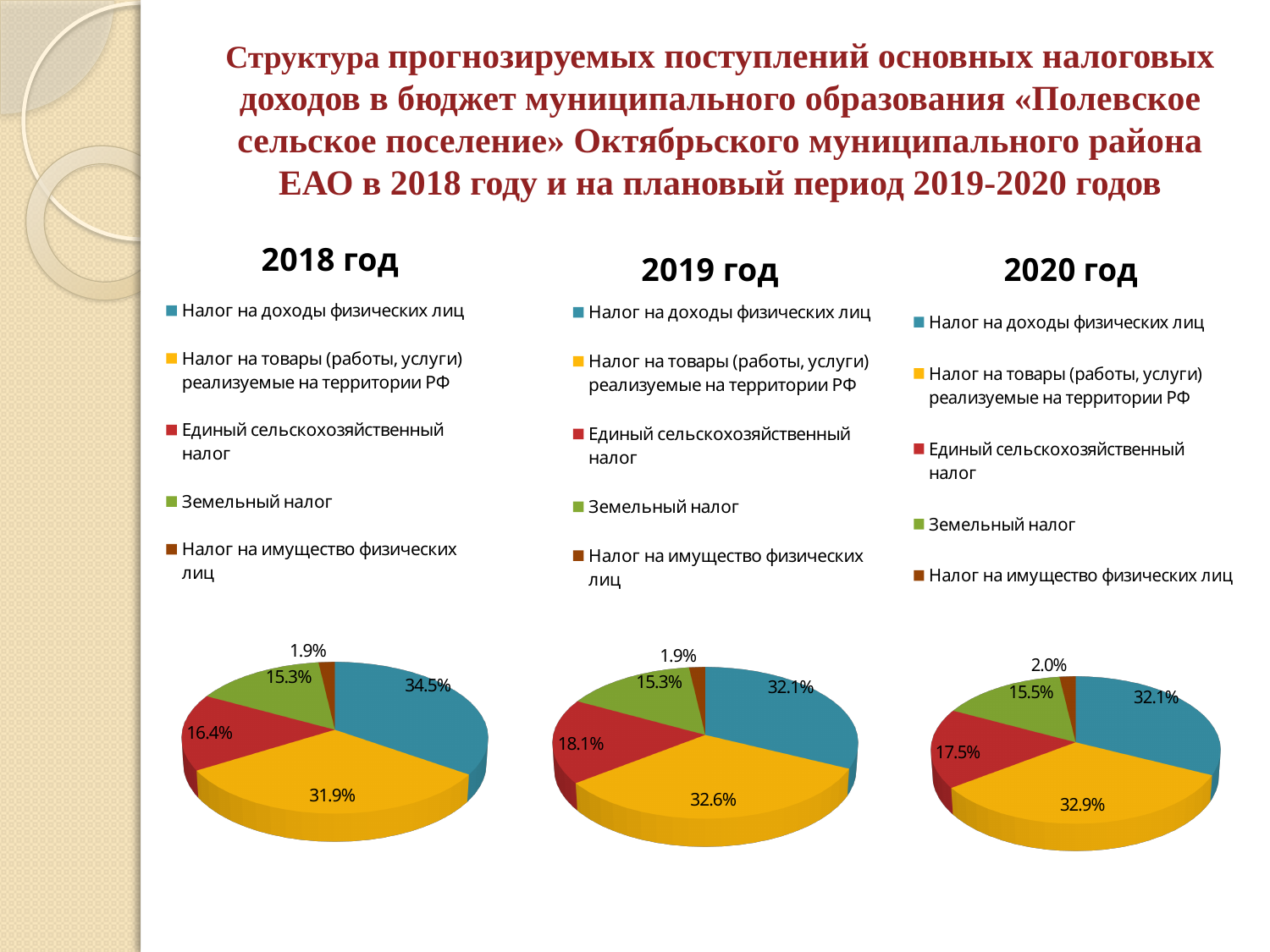
What type of chart is used for "2018 год"? Pie chart In the "2019 год" chart, which category has the smallest share? Налог на имущество физических лиц In the "2018 год" chart, which category has the largest share? Налог на доходы физических лиц In the "2020 год" chart, which is larger: the share of Единый сельскохозяйственный налог or the share of Земельный налог? Единый сельскохозяйственный налог In the "2018 год" chart, what is the difference between the shares of Налог на доходы физических лиц and Налог на товары (работы, услуги) реализуемые на территории РФ? 2.6% In the "2020 год" chart, what share is shown for Налог на товары (работы, услуги) реализуемые на территории РФ? 32.9% In the "2019 год" chart, what colour is the slice for Земельный налог? Green How many slices does the "2019 год" pie chart have? 5 In the "2019 год" chart, what share is shown for Единый сельскохозяйственный налог? 18.1% How many charts are shown on the slide? 3 In the "2020 год" chart, what share is shown for Налог на имущество физических лиц? 2.0% In the "2018 год" chart, what share is shown for Налог на доходы физических лиц? 34.5%